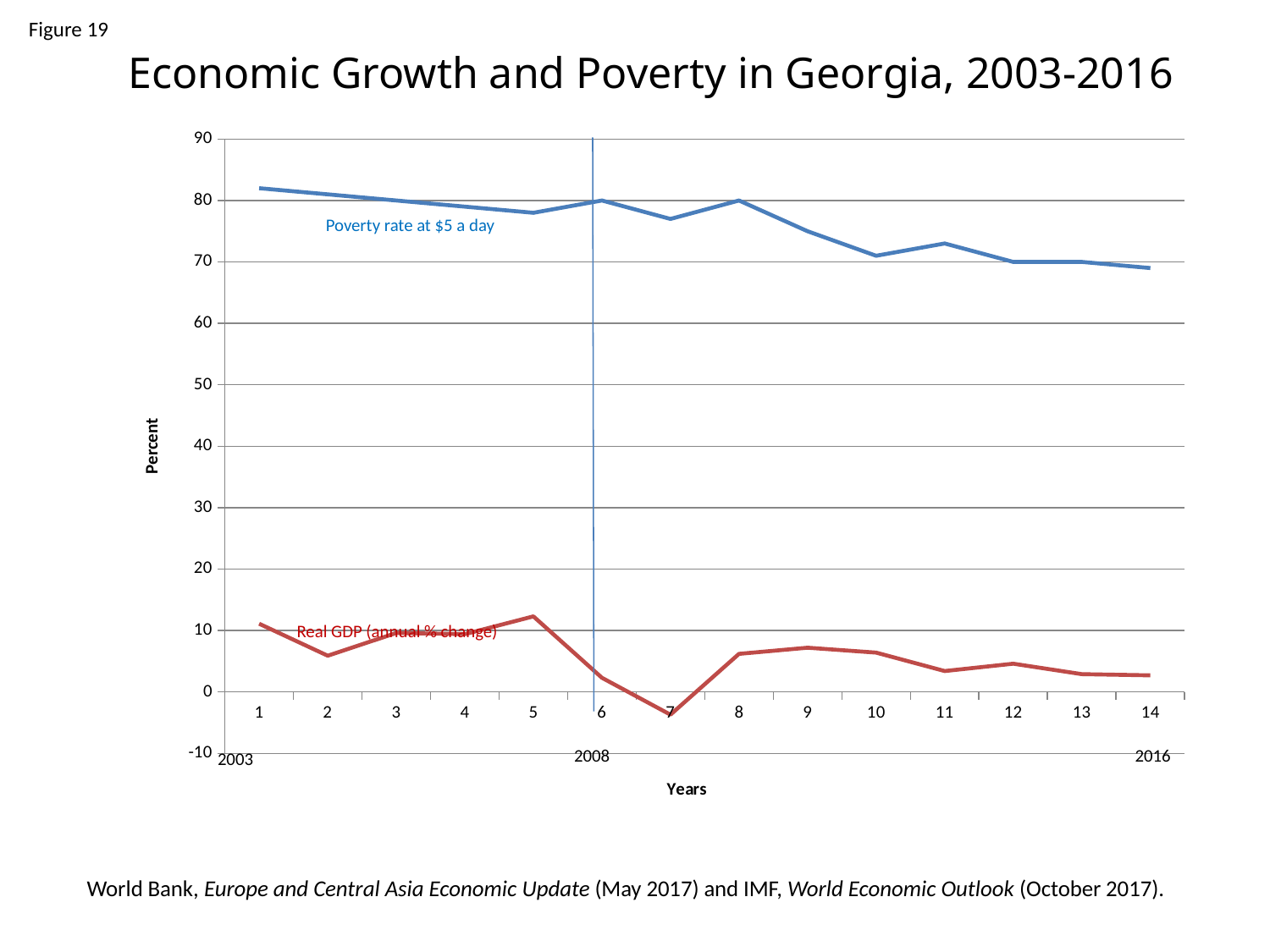
Is the Poverty rate at $5 a day at x = 1 greater or less than 80? greater At which x-axis point is Real GDP (annual % change) highest? 5 What is the title of the chart's vertical axis? Percent How many data points are plotted along the x axis for each series? 14 How many data series are plotted in the chart? 2 Does the Poverty rate at $5 a day generally rise or fall from x = 1 to x = 14? fall What type of chart is shown on the slide? line chart Is the Real GDP (annual % change) value at x = 5 greater or less than 10? greater Is the Real GDP (annual % change) value at x = 7 greater or less than 0? less Which is larger: the Poverty rate at $5 a day at x = 1 or at x = 14? x = 1 At which x-axis point is Real GDP (annual % change) lowest? 7